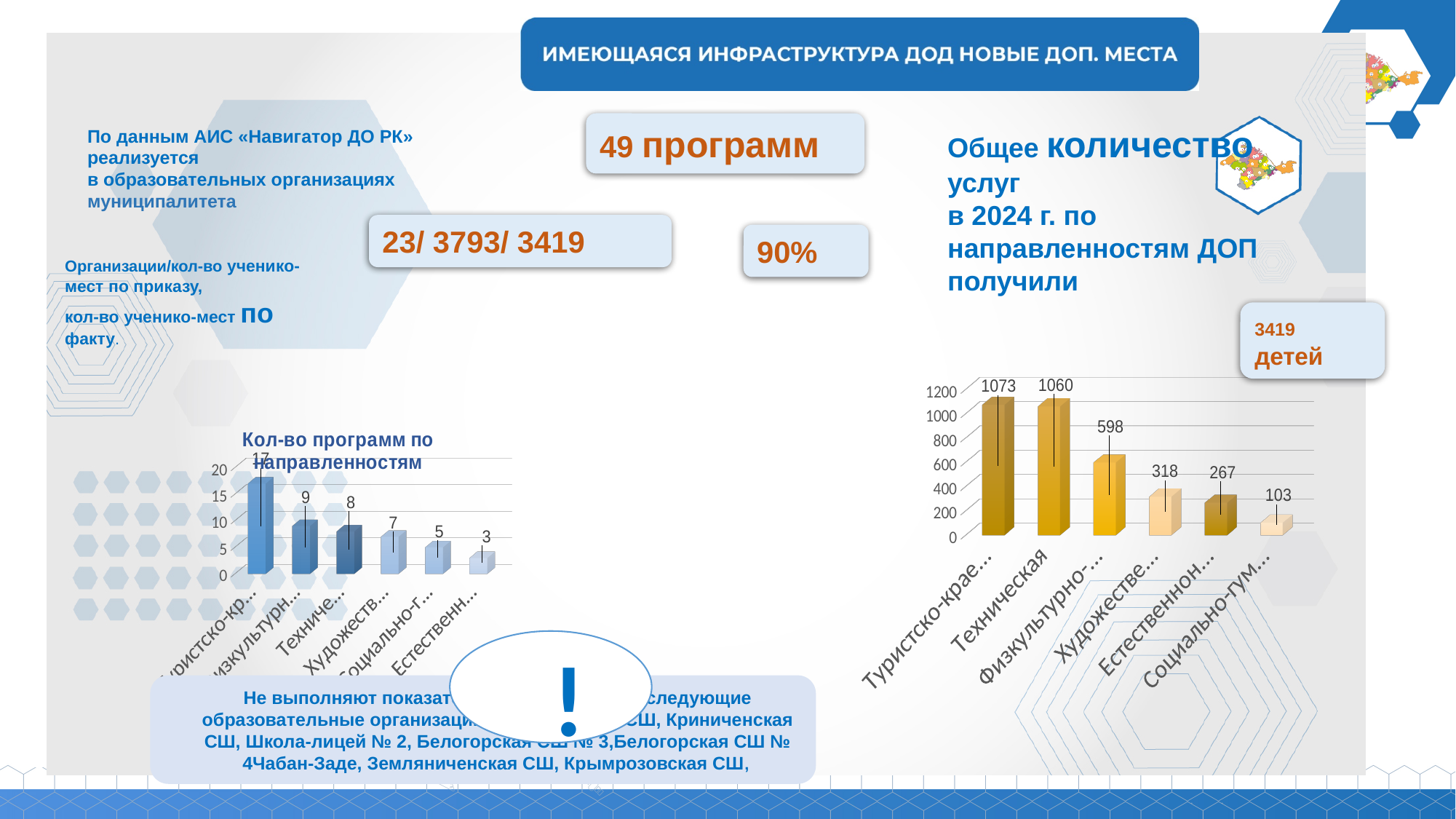
In the chart 'Кол-во программ по направленностям' on the left, what is the value for the 'Художеств...' category? 7 In the chart 'Кол-во программ по направленностям' on the left, what is the value for the 'Туристско-кр...' category? 17 In the chart 'Кол-во программ по направленностям' on the left, do the values rise or fall from left to right along the x axis? fall What type of chart is the chart on the right (количество услуг в 2024 г. по направленностям)? bar chart In the chart on the right (количество услуг в 2024 г. по направленностям), what is the value for 'Физкультурно-...'? 598 In the chart on the right (количество услуг в 2024 г. по направленностям), which is larger: the value for 'Художестве...' or the value for 'Естественнон...'? Художестве... In the chart on the right (количество услуг в 2024 г. по направленностям), what is the difference between the 'Туристско-крае...' value and the 'Социально-гум...' value? 970 In the chart 'Кол-во программ по направленностям' on the left, what is the difference between the 'Туристско-кр...' value and the 'Физкультурн...' value? 8 In the chart 'Кол-во программ по направленностям' on the left, which category has the lowest value? Естественн... In the chart on the right (количество услуг в 2024 г. по направленностям), which category has the highest value? Туристско-крае... In the chart 'Кол-во программ по направленностям' on the left, how many categories are shown? 6 In the chart on the right (количество услуг в 2024 г. по направленностям), what is the value for 'Техническая'? 1060